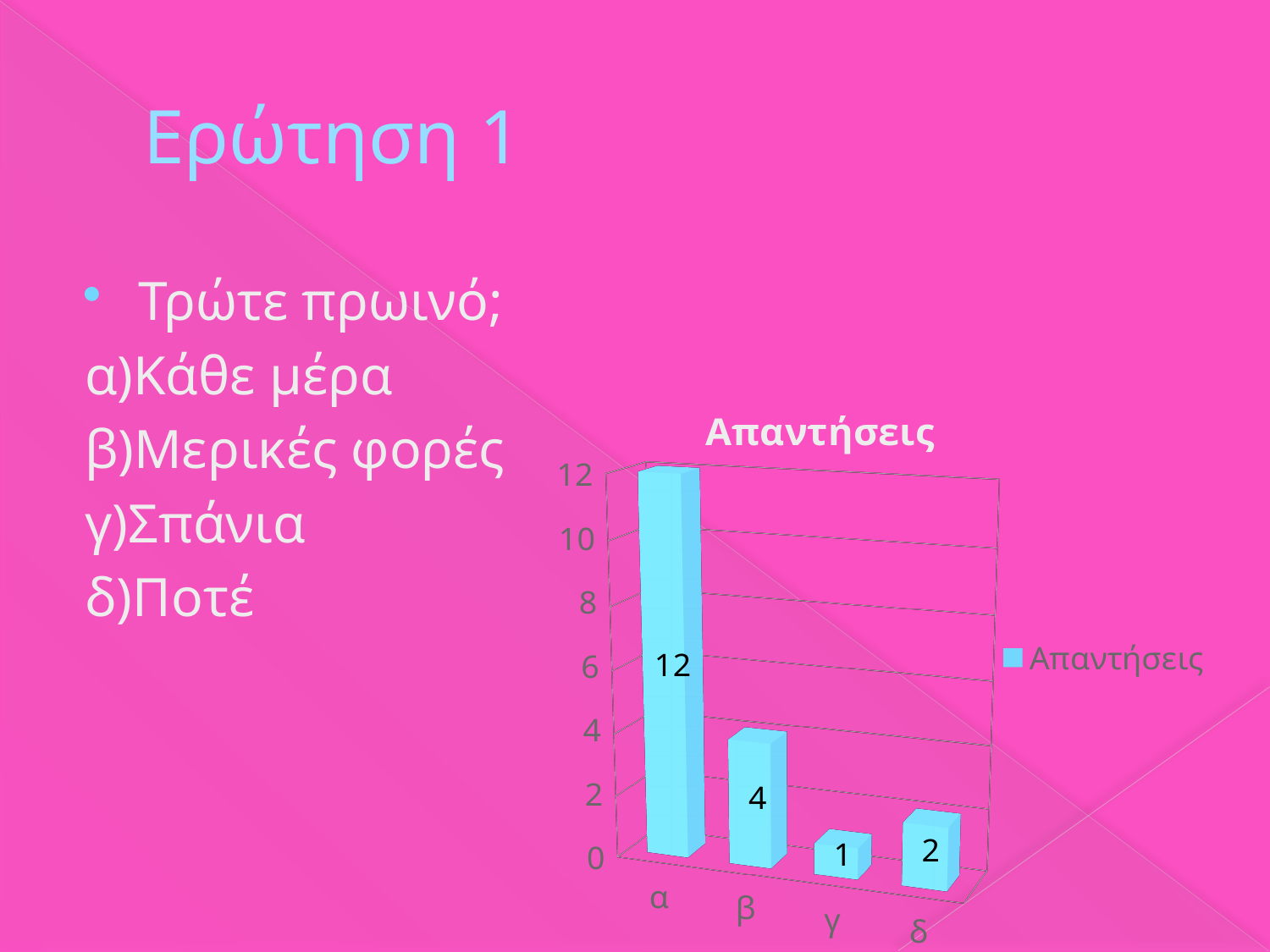
What is the value for category β? 4 What is the value for category γ? 1 Which category has the lowest value? γ How many categories are shown on the x axis? 4 Which category has the highest value? α What is the difference between the values for α and β? 8 What is the value for category δ? 2 What kind of chart is shown on the slide? bar chart What is the value for category α? 12 Is the value for β greater or less than 6? less Which is larger, the value for δ or the value for γ? δ What is the title of the chart? Απαντήσεις